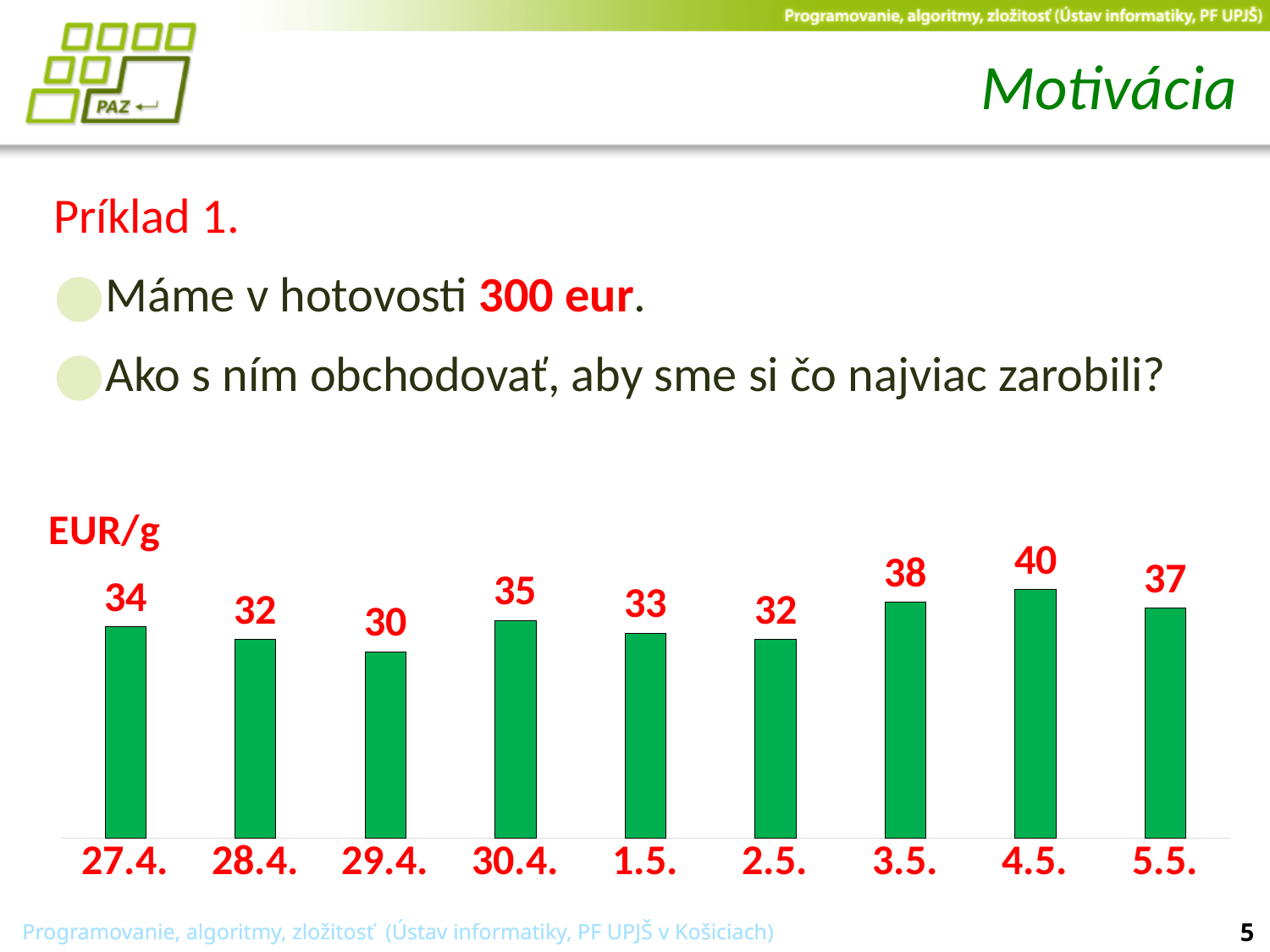
What is the difference between the values for 30.4. and 1.5.? 2 Which date has the highest value? 4.5. What is the value for 27.4.? 34 Which date has the lowest value? 29.4. What kind of chart is shown on the slide? bar chart Which is larger, the value for 28.4. or the value for 30.4.? 30.4. What unit label is shown above the chart? EUR/g What is the value for 3.5.? 38 What is the difference between the values for 4.5. and 29.4.? 10 How many dates are shown on the x axis? 9 Do the values rise or fall from 2.5. to 4.5.? rise What is the value for 5.5.? 37